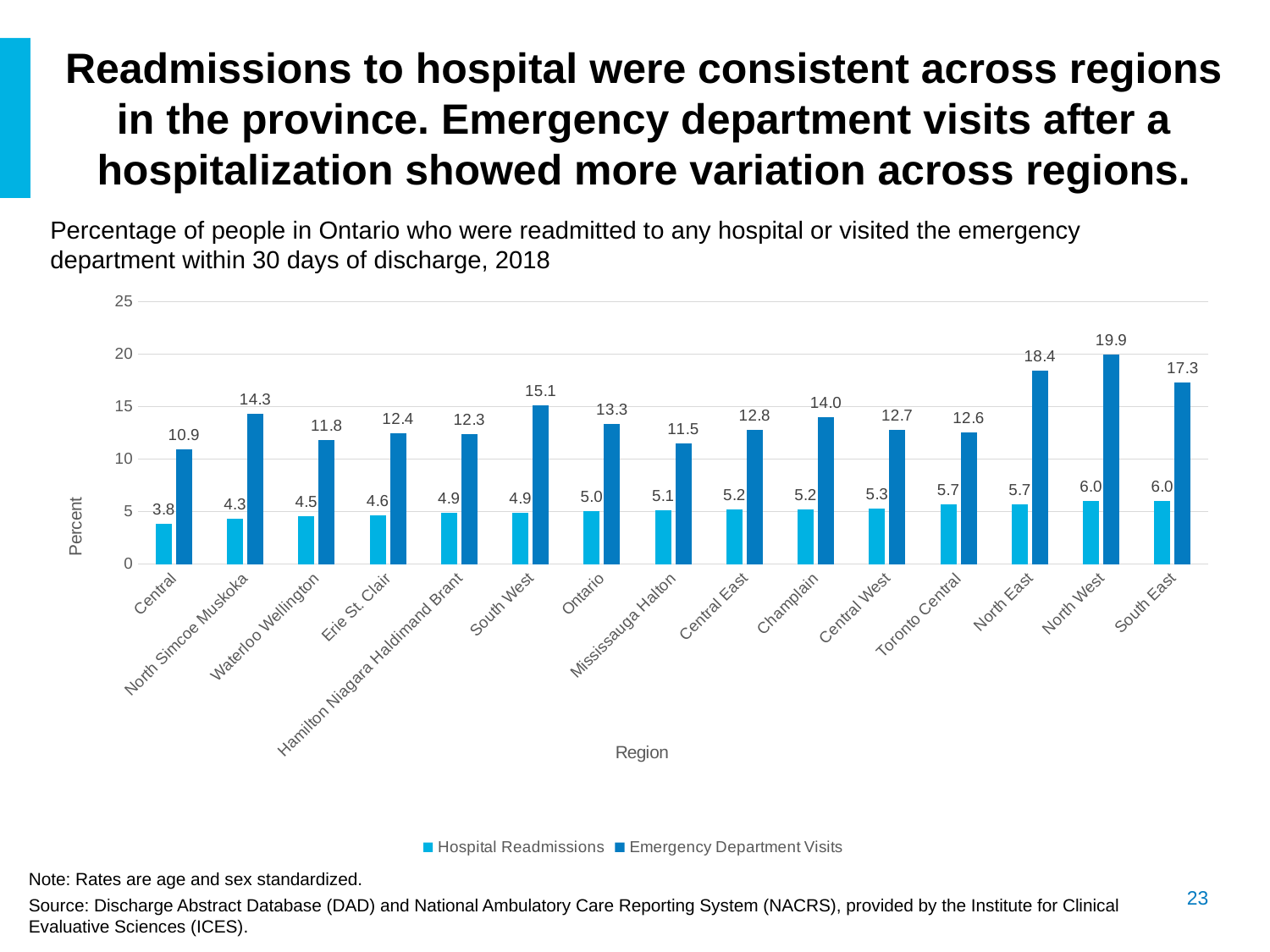
Which region has the lowest Emergency Department Visits value? Central What is the Emergency Department Visits value for South West? 15.1 What is the Emergency Department Visits value for Ontario? 13.3 How many series does the legend list? 2 How many regions are shown on the x axis of the chart? 15 What kind of chart is shown on the slide? Bar chart What is the difference between the Emergency Department Visits values for North East and South East? 1.1 Which region has the highest Emergency Department Visits value? North West What is the Hospital Readmissions value for Toronto Central? 5.7 Which region has the lowest Hospital Readmissions value? Central What is the difference between the Emergency Department Visits and Hospital Readmissions values for North West? 13.9 Which has a higher Emergency Department Visits value, Champlain or Central East? Champlain